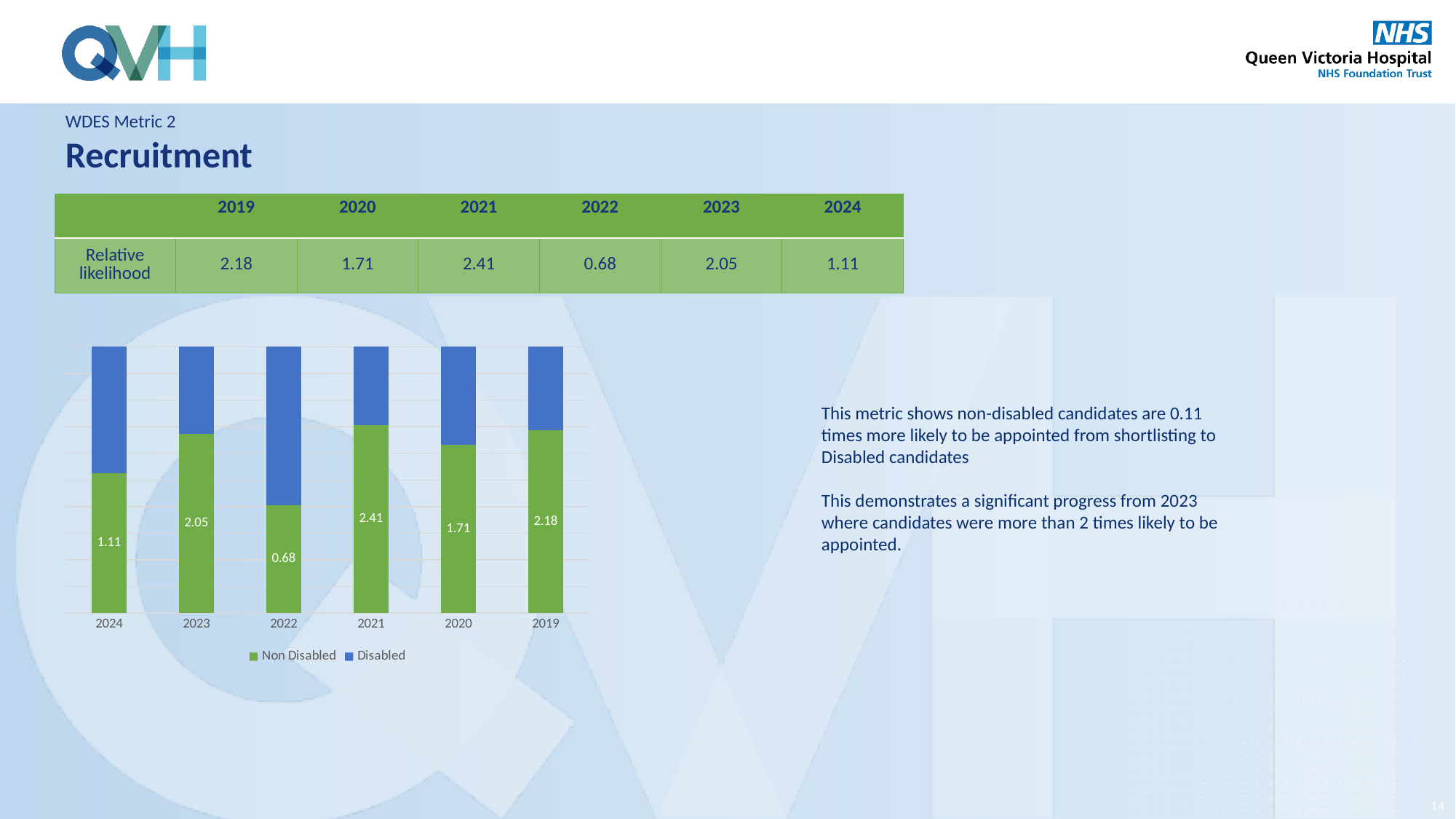
Which year has the lowest labelled Non Disabled value? 2022 Which has the larger labelled Non Disabled value, 2019 or 2020? 2019 What is the difference between the labelled Non Disabled values for 2023 and 2024? 0.94 What is the Non Disabled value labelled on the bar for 2024? 1.11 How many series does the chart legend list? 2 Which series is shown in blue in the chart? Disabled What type of chart is shown on the slide? Stacked bar chart What is the Non Disabled value labelled on the bar for 2021? 2.41 Which year has the highest labelled Non Disabled value? 2021 What is the Non Disabled value labelled on the bar for 2022? 0.68 How many years are shown on the x axis of the chart? 6 What is the Non Disabled value labelled on the bar for 2020? 1.71